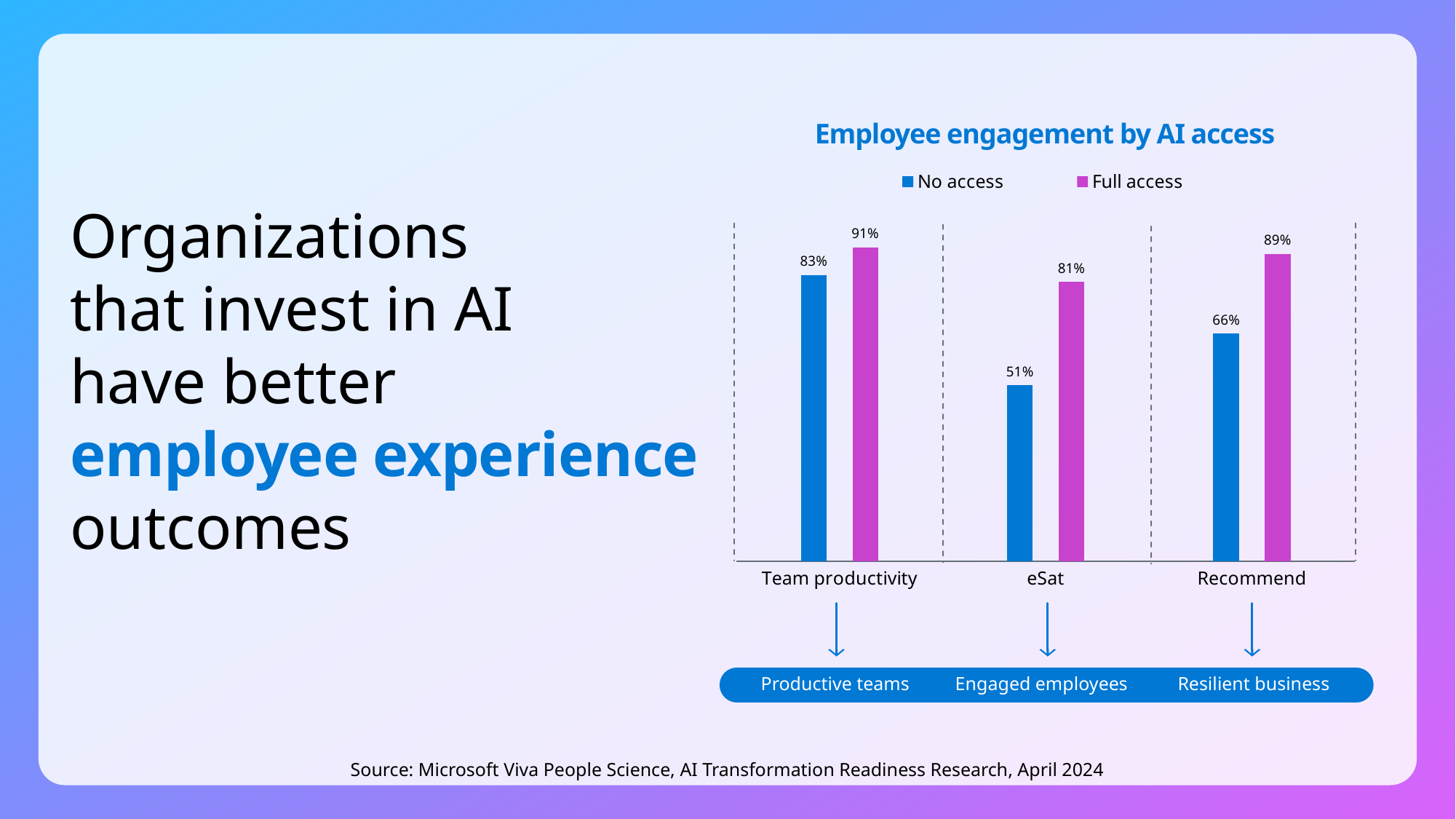
What is the value for Full access in the Recommend category? 89% What is the value for Full access in the eSat category? 81% Which category has the lowest No access value? eSat How many categories are shown on the x axis? 3 What is the value for No access in the Recommend category? 66% What is the value for No access in the Team productivity category? 83% What is the difference between the Full access and No access values for eSat? 30% How many series does the legend list? 2 Which category has the highest Full access value? Team productivity What kind of chart is shown on the slide? Bar chart Which is larger for Recommend: the No access value or the Full access value? Full access What is the difference between the Full access and No access values for Team productivity? 8%